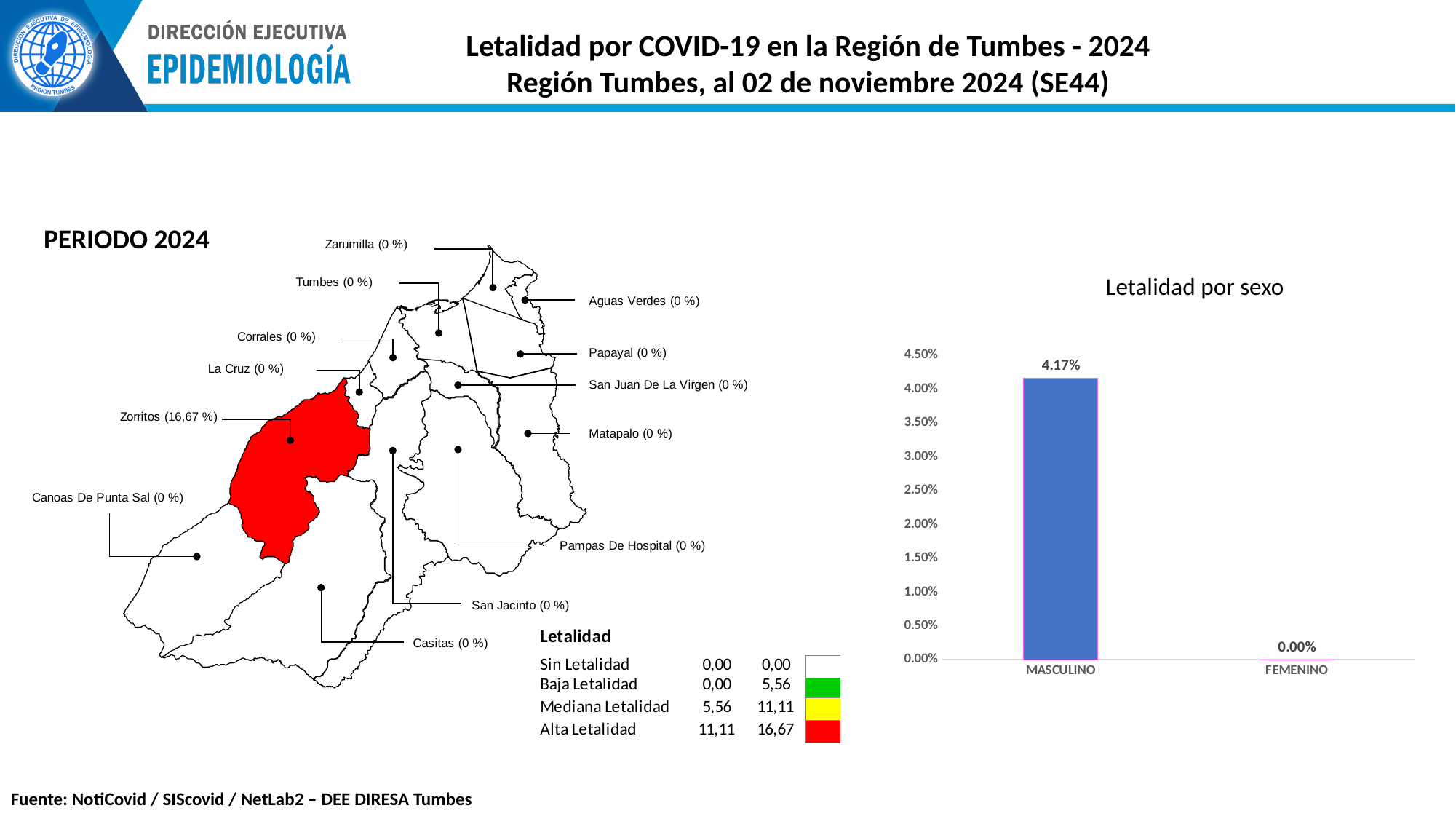
In the 'Letalidad por sexo' chart, which category has the highest value? MASCULINO In the 'Letalidad por sexo' chart, which is larger, the value for MASCULINO or for FEMENINO? MASCULINO What kind of chart is 'Letalidad por sexo'? bar chart In the 'Letalidad por sexo' chart, what is the value for MASCULINO? 4.17% How many categories are shown on the x axis of the 'Letalidad por sexo' chart? 2 In the 'Letalidad por sexo' chart, is the value for MASCULINO greater or less than 4.00%? greater What is the title of the chart on the right side of the slide? Letalidad por sexo In the 'Letalidad por sexo' chart, what is the difference between the MASCULINO and FEMENINO values? 4.17% On the map on the left, what lethality percentage is shown for Zorritos? 16,67 % What is the highest tick label on the y axis of the 'Letalidad por sexo' chart? 4.50% In the 'Letalidad por sexo' chart, what is the value for FEMENINO? 0.00% In the 'Letalidad por sexo' chart, which category has the lowest value? FEMENINO